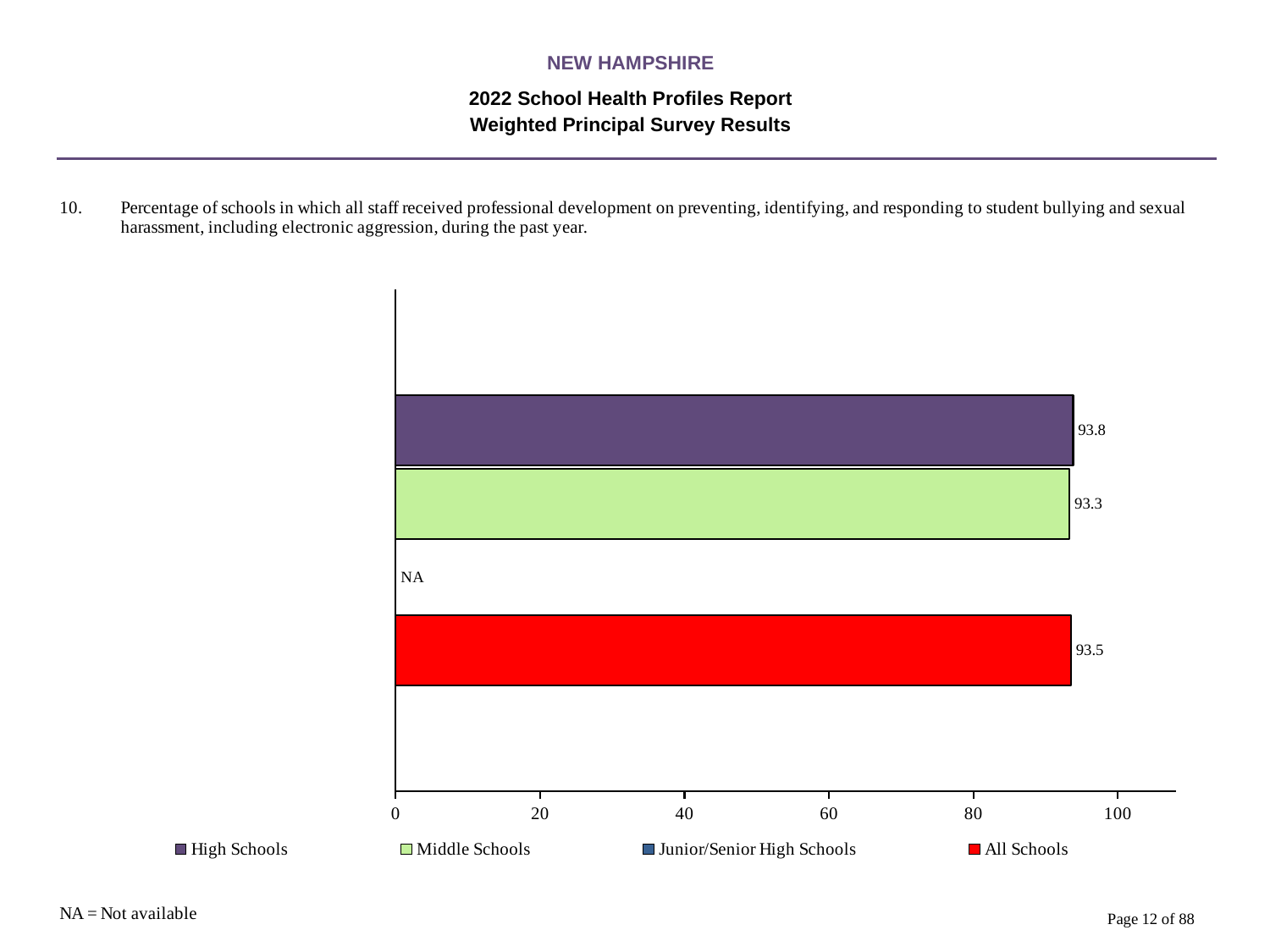
What kind of chart is shown on the slide? bar chart Which school type has the highest value? High Schools What is the value for High Schools? 93.8 How many series does the legend list? 4 What is shown for Junior/Senior High Schools? NA What is the value for All Schools? 93.5 Which is larger, the value for High Schools or the value for All Schools? High Schools Which school type with a plotted value has the lowest value? Middle Schools What colour is the bar for All Schools? red What is the difference between the High Schools value and the Middle Schools value? 0.5 What is the value for Middle Schools? 93.3 Is the value for Middle Schools greater or less than 80? greater